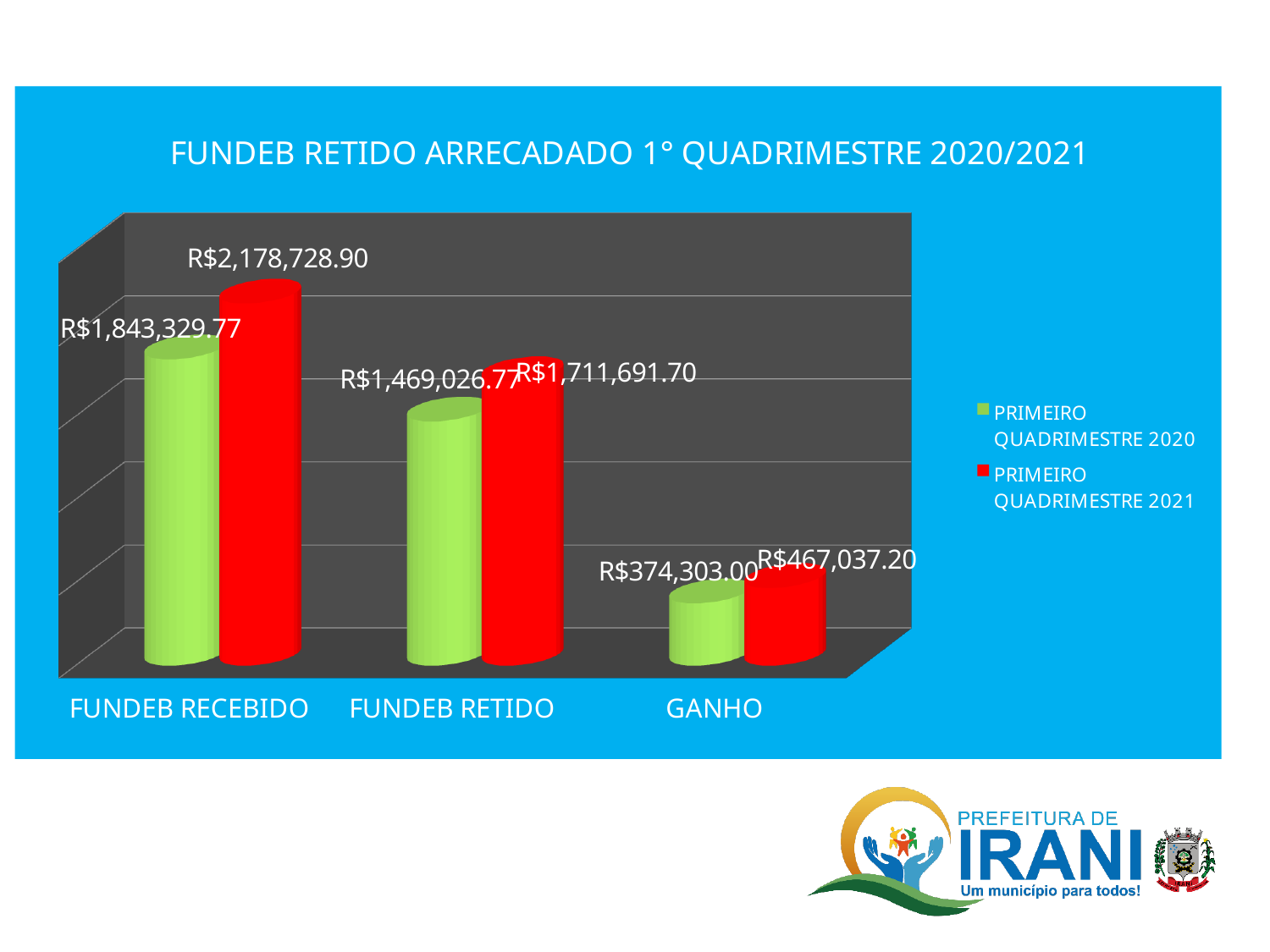
For FUNDEB RETIDO, which series has the larger value: PRIMEIRO QUADRIMESTRE 2020 or PRIMEIRO QUADRIMESTRE 2021? PRIMEIRO QUADRIMESTRE 2021 What kind of chart is shown on the slide? Bar chart Which category has the highest value in the PRIMEIRO QUADRIMESTRE 2021 series? FUNDEB RECEBIDO What is the value for FUNDEB RECEBIDO in the PRIMEIRO QUADRIMESTRE 2021 series? R$2,178,728.90 What is the difference between the 2021 and 2020 values for GANHO? R$92,734.20 Which category has the lowest value in the PRIMEIRO QUADRIMESTRE 2020 series? GANHO What is the difference between the 2021 and 2020 values for FUNDEB RECEBIDO? R$335,399.13 How many series does the legend list? 2 What is the value for FUNDEB RECEBIDO in the PRIMEIRO QUADRIMESTRE 2020 series? R$1,843,329.77 What is the value for FUNDEB RETIDO in the PRIMEIRO QUADRIMESTRE 2020 series? R$1,469,026.77 What is the value for GANHO in the PRIMEIRO QUADRIMESTRE 2021 series? R$467,037.20 How many categories are shown on the x axis? 3